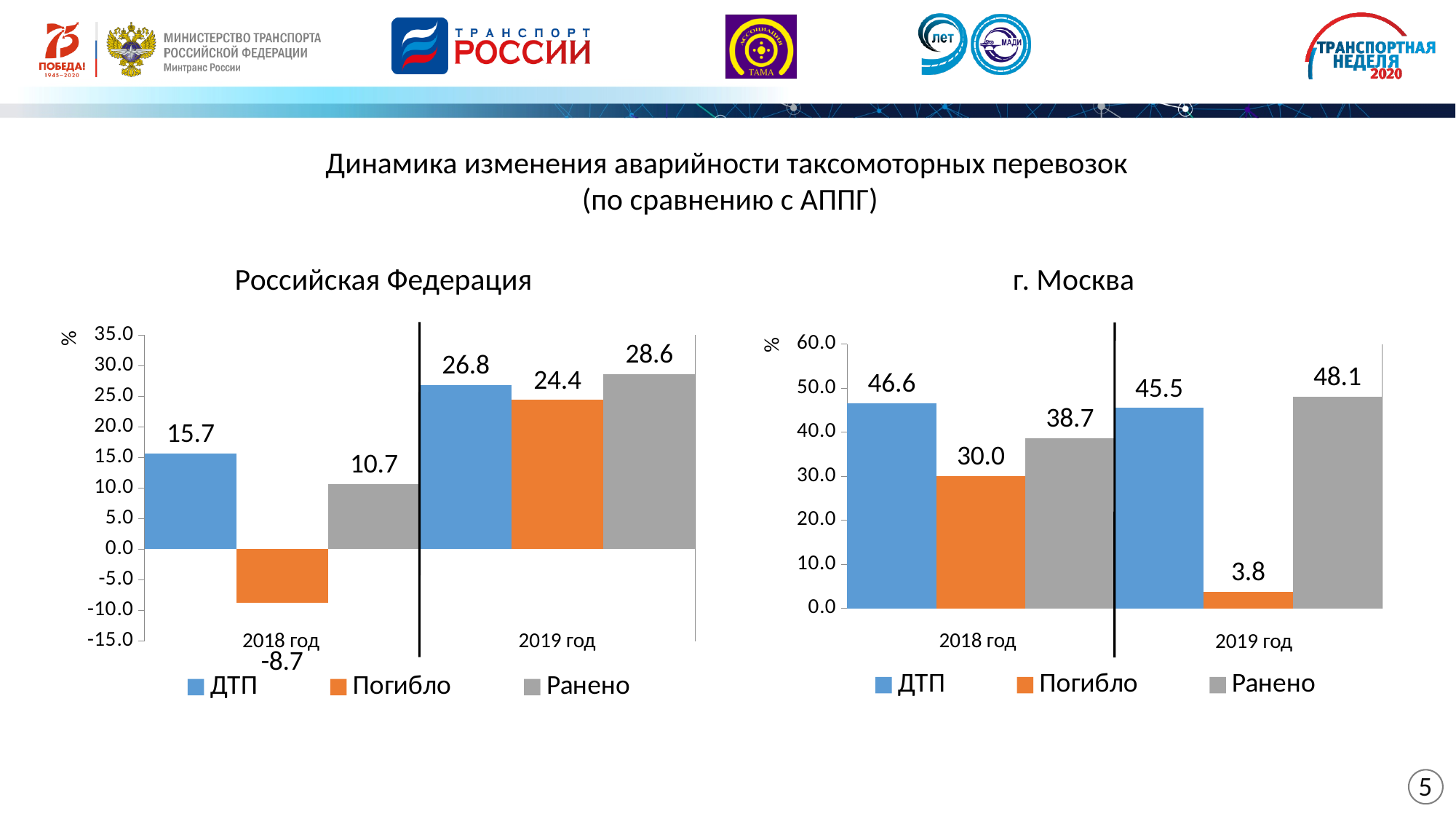
In the 'г. Москва' chart, which is larger: ДТП in 2018 год or ДТП in 2019 год? ДТП in 2018 год In the 'г. Москва' chart, which series has the highest value in 2019 год? Ранено In the 'Российская Федерация' chart, what is the value for Ранено in 2019 год? 28.6 What kind of chart is the 'Российская Федерация' chart? Bar chart In the 'г. Москва' chart, what is the value for Погибло in 2019 год? 3.8 In the 'Российская Федерация' chart, what is the difference between the ДТП values for 2019 год and 2018 год? 11.1 In the 'Российская Федерация' chart, which series has the lowest value in 2018 год? Погибло In the 'г. Москва' chart, what is the value for Ранено in 2018 год? 38.7 In the 'г. Москва' chart, does the Погибло value rise or fall from 2018 год to 2019 год? Fall How many series does the legend of the 'г. Москва' chart list? 3 In the 'Российская Федерация' chart, what is the value for ДТП in 2018 год? 15.7 In the 'Российская Федерация' chart, what is the value for Погибло in 2018 год? -8.7